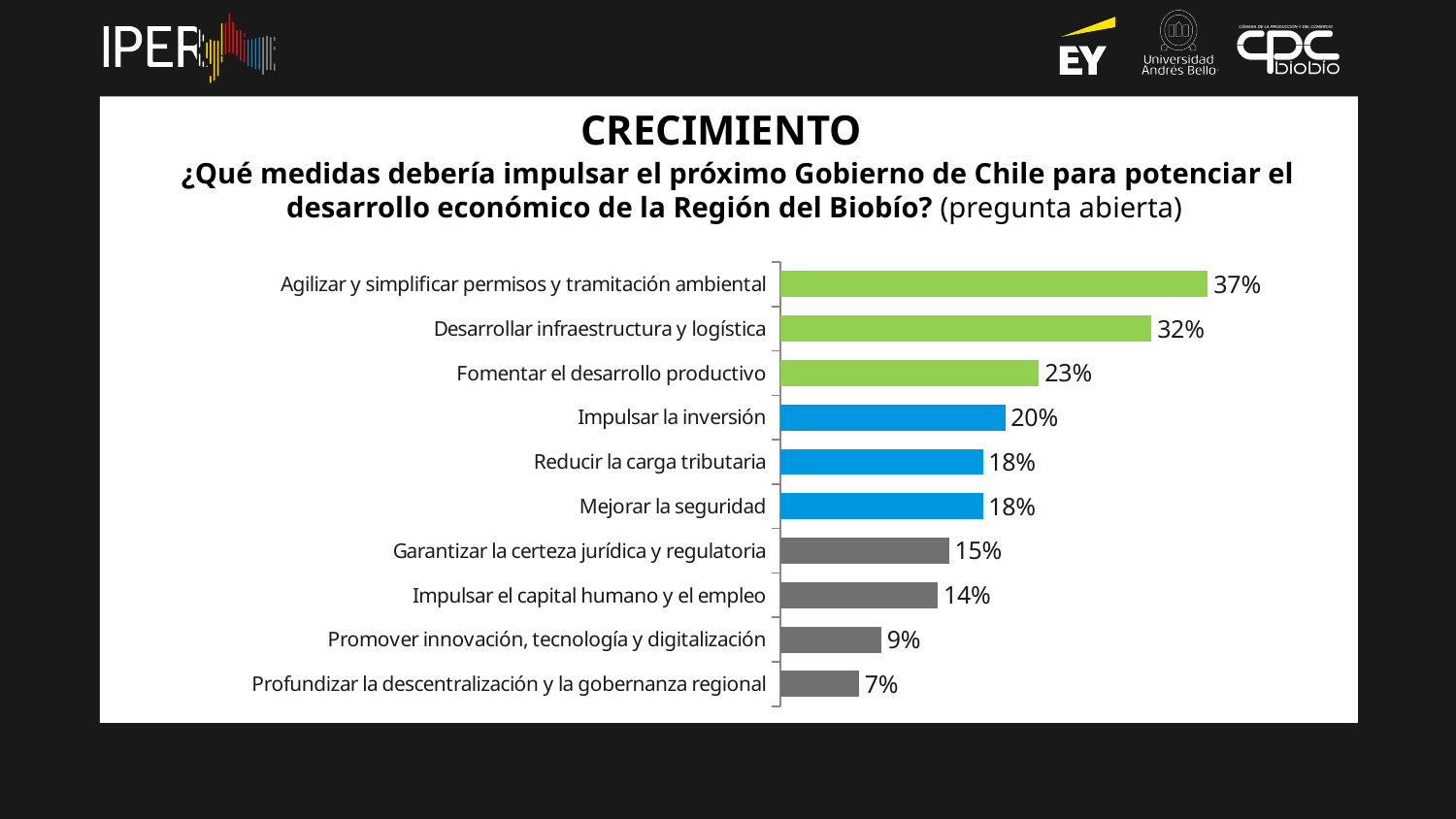
How many categories are shown in the chart? 10 How many bars are coloured green? 3 What is the difference between "Desarrollar infraestructura y logística" and "Fomentar el desarrollo productivo"? 9% What is the difference between "Agilizar y simplificar permisos y tramitación ambiental" and "Profundizar la descentralización y la gobernanza regional"? 30% What is the value for "Impulsar la inversión"? 20% What is the value for "Reducir la carga tributaria"? 18% Which is larger: "Garantizar la certeza jurídica y regulatoria" or "Impulsar el capital humano y el empleo"? Garantizar la certeza jurídica y regulatoria Which category has the lowest value? Profundizar la descentralización y la gobernanza regional What is the value for "Agilizar y simplificar permisos y tramitación ambiental"? 37% What kind of chart is shown on the slide? Bar chart Which category has the highest value? Agilizar y simplificar permisos y tramitación ambiental What is the value for "Promover innovación, tecnología y digitalización"? 9%